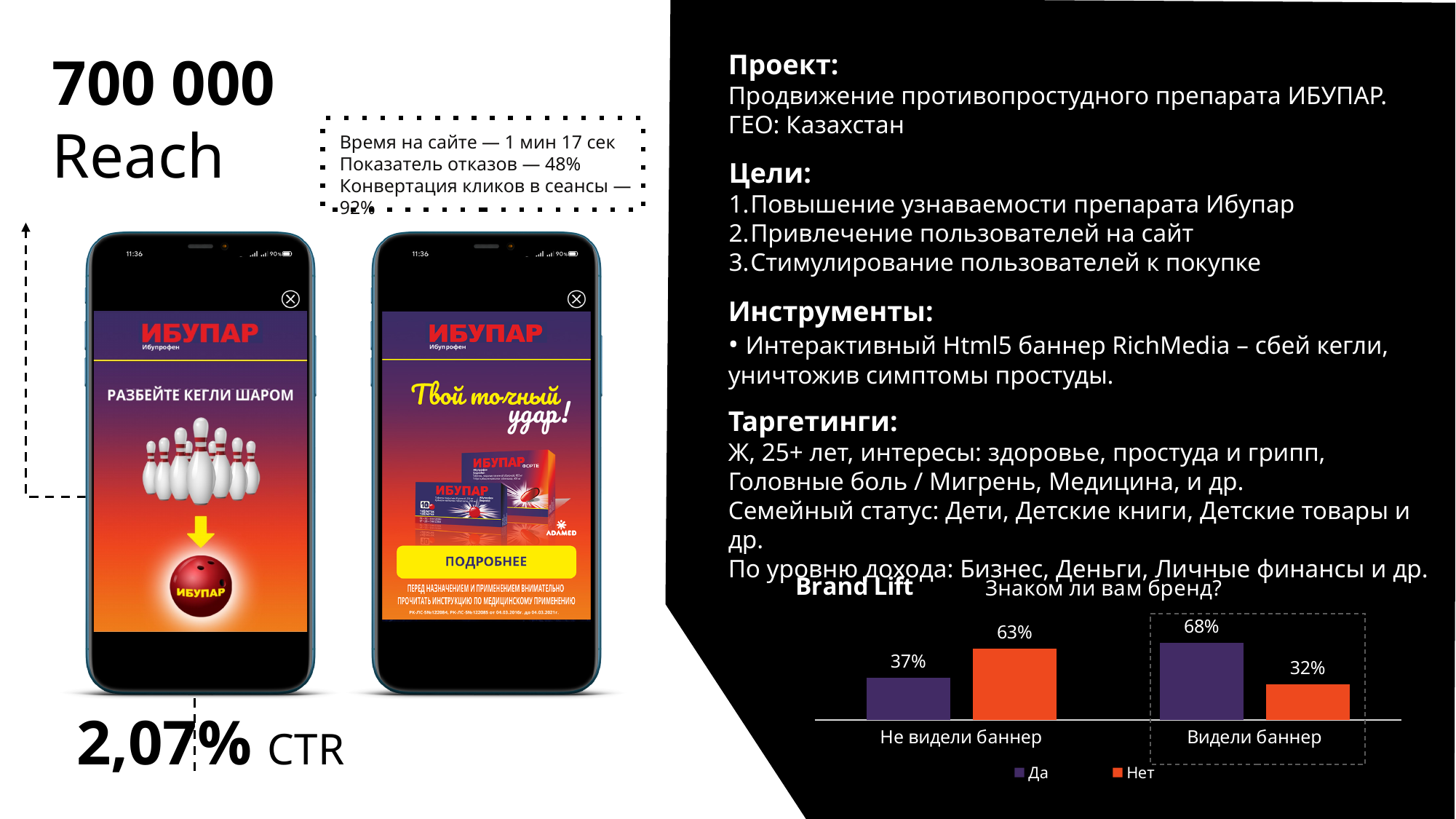
In the "Знаком ли вам бренд?" chart, what is the difference between the "Да" values for "Видели баннер" and "Не видели баннер"? 31% In the "Знаком ли вам бренд?" chart, which colour represents the "Нет" series? orange In the "Знаком ли вам бренд?" chart, what is the value of "Нет" for "Не видели баннер"? 63% In the "Знаком ли вам бренд?" chart, what is the value of "Да" for "Видели баннер"? 68% How many categories are shown on the x axis of the "Знаком ли вам бренд?" chart? 2 How many series does the legend of the "Знаком ли вам бренд?" chart list? 2 In the "Знаком ли вам бренд?" chart, which category has the highest "Да" value? Видели баннер In the "Знаком ли вам бренд?" chart, which is larger for "Видели баннер": "Да" or "Нет"? Да What kind of chart is shown under the title "Знаком ли вам бренд?"? bar chart In the "Знаком ли вам бренд?" chart, what is the value of "Да" for "Не видели баннер"? 37% In the "Знаком ли вам бренд?" chart, what is the value of "Нет" for "Видели баннер"? 32% In the "Знаком ли вам бренд?" chart, which category has the lowest "Нет" value? Видели баннер